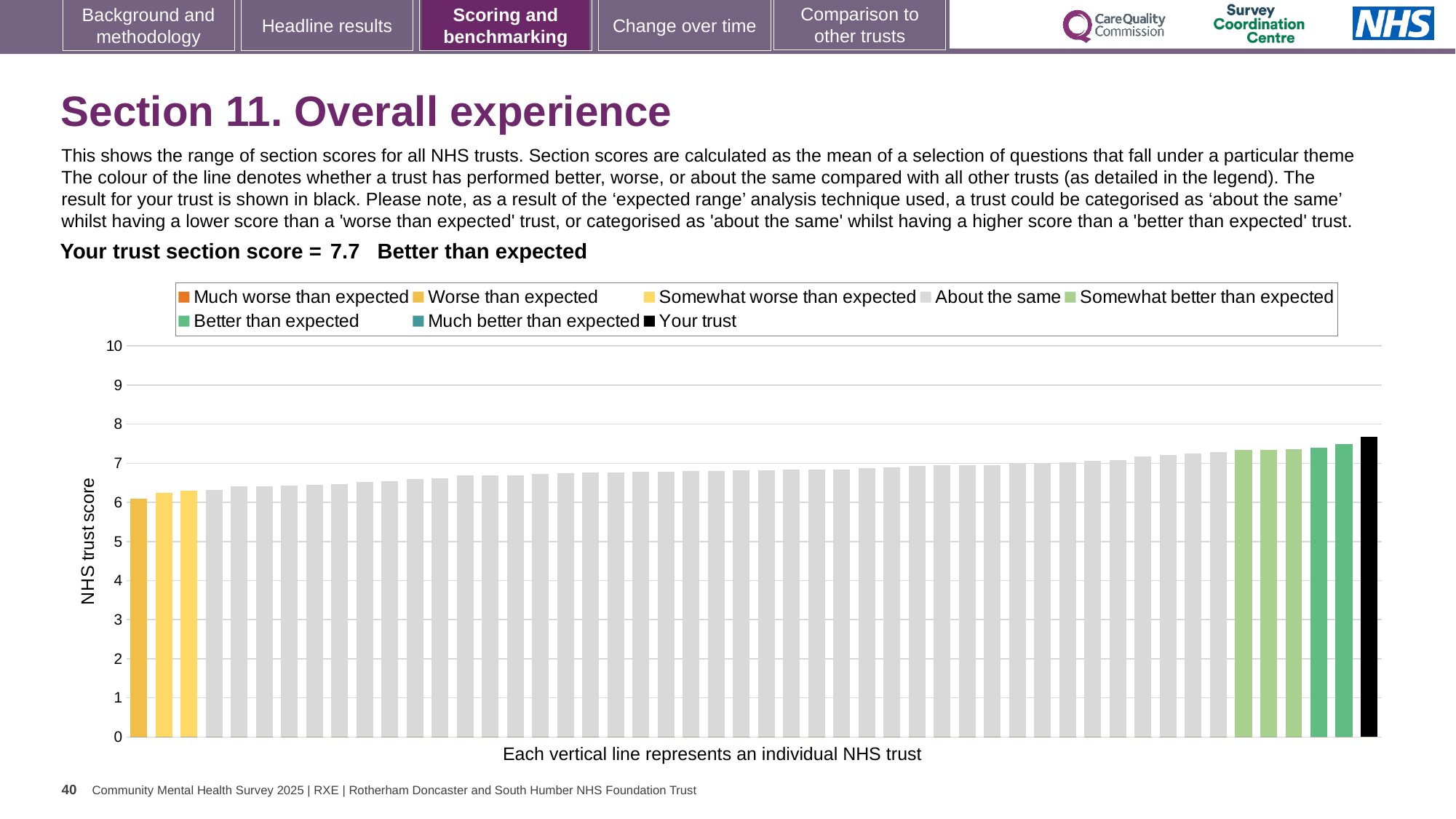
Which category is your trust placed in for this section? Better than expected Is the value for the leftmost bar greater or less than 7? less Which bar is the highest in the chart? Your trust (the black bar) What kind of chart is shown on the slide? bar chart Is the value for the leftmost bar greater or less than 5? greater Do the bar values rise or fall from left to right along the x axis? rise How many entries does the chart legend list? 8 What is the section score for your trust? 7.7 What is the label on the vertical axis of the chart? NHS trust score Is the value for the black 'Your trust' bar greater or less than 7? greater How many bars are coloured in green shades (somewhat better or better than expected)? 5